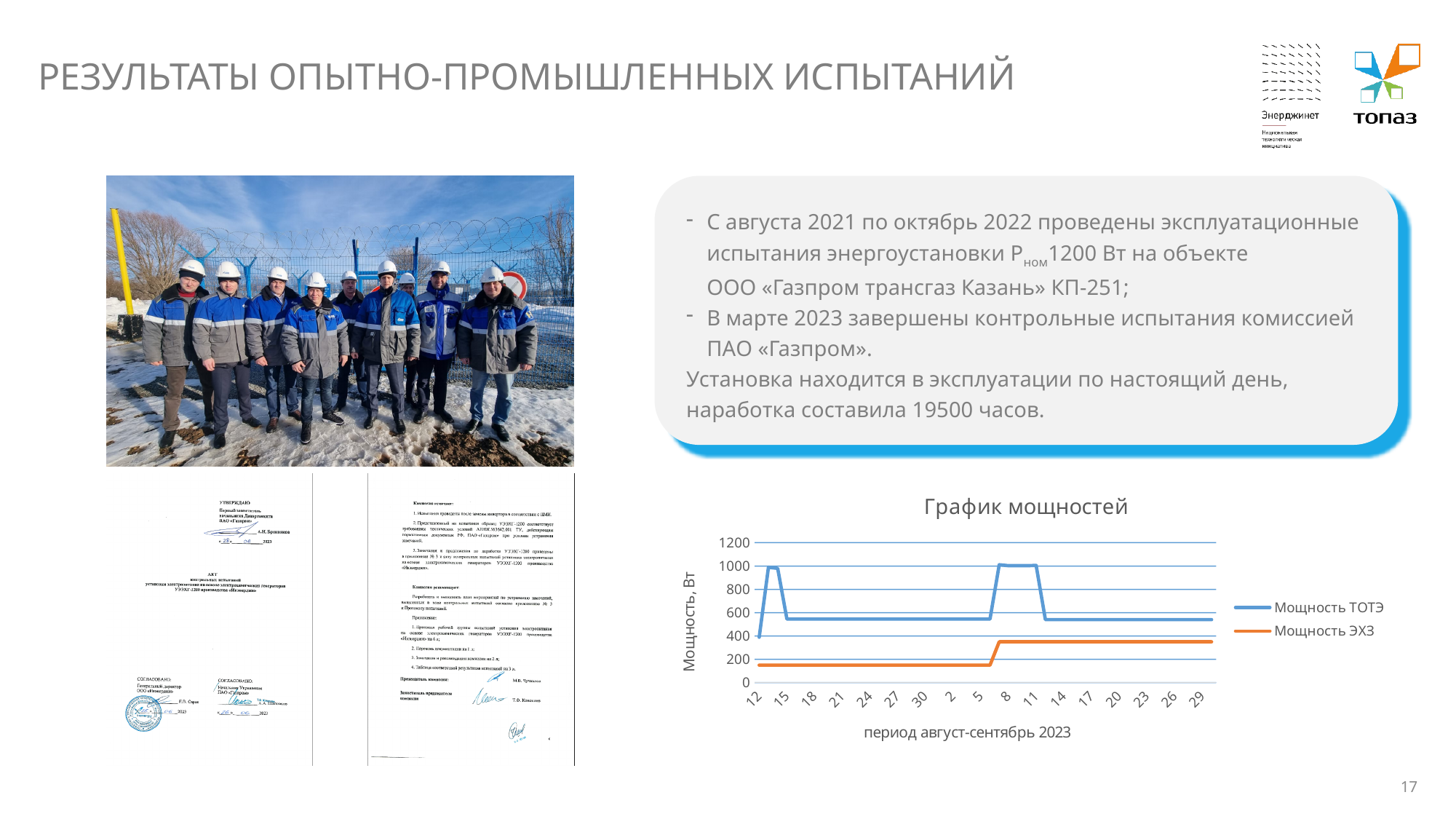
In "График мощностей", is the value for Мощность ТОТЭ at 29 greater or less than 400? greater What is the y-axis title of the chart "График мощностей"? Мощность, Вт In "График мощностей", which series has the higher value at 20: Мощность ТОТЭ or Мощность ЭХЗ? Мощность ТОТЭ In "График мощностей", is the value for Мощность ТОТЭ at 18 greater or less than 800? less In "График мощностей", is the peak value of Мощность ТОТЭ greater or less than 800? greater What is the title of the chart on the slide? График мощностей What kind of chart is "График мощностей"? line chart How many series does the legend of "График мощностей" list? 2 In "График мощностей", does the Мощность ЭХЗ series rise or fall from the start to the end of the period? rise